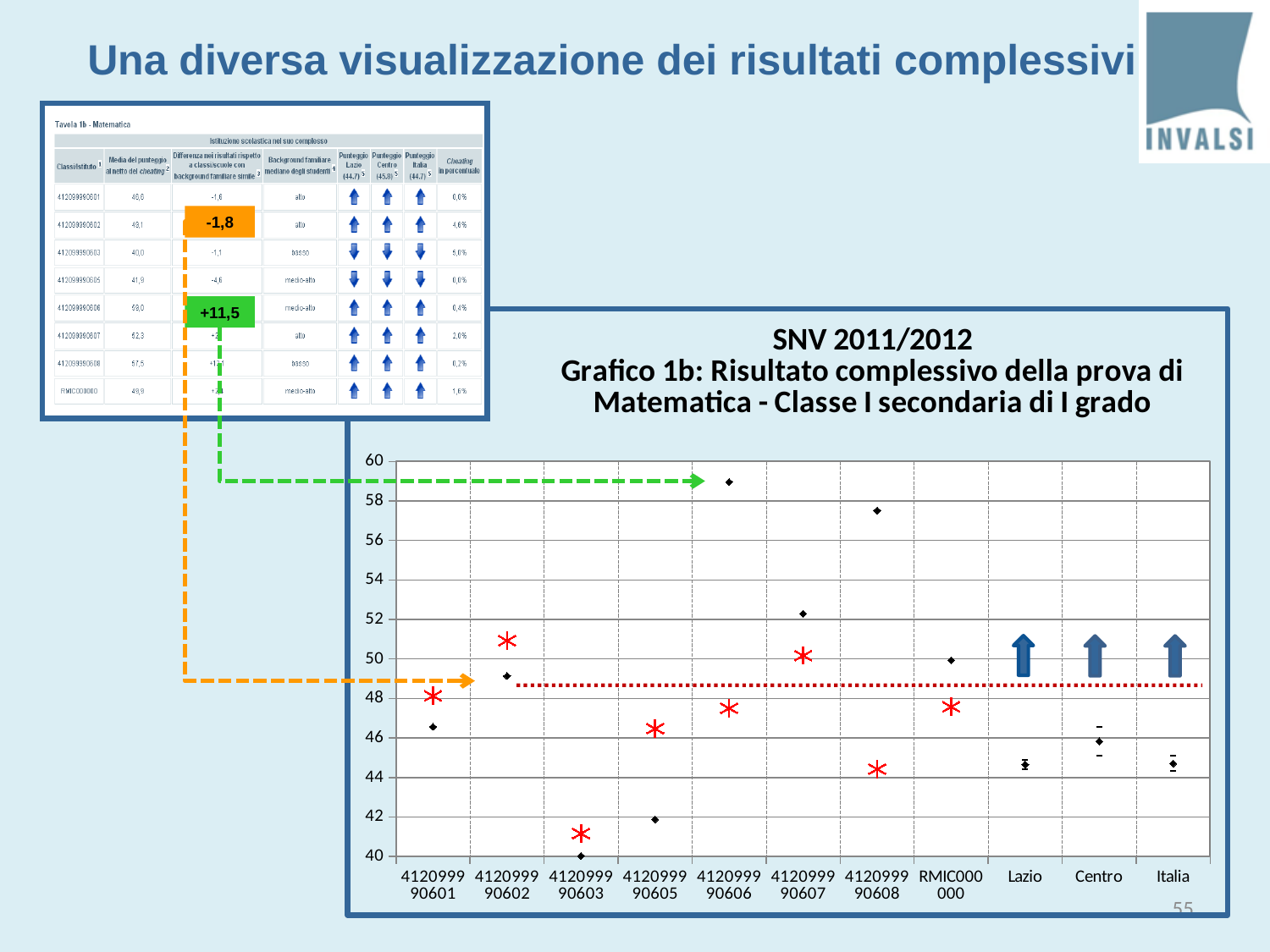
What is the range of the y axis in the chart 'Grafico 1b'? 40 to 60 In the chart 'Grafico 1b', is the value for 412099990605 greater or less than 44? less What kind of chart is 'Grafico 1b: Risultato complessivo della prova di Matematica'? scatter (dot) chart In the chart 'Grafico 1b', which has the larger value: 412099990608 or 412099990607? 412099990608 How many categories are shown on the x axis of the chart 'Grafico 1b'? 11 In the chart 'Grafico 1b', is the value for 412099990606 greater or less than 58? greater In the chart 'Grafico 1b', is the value for 412099990608 greater or less than 56? greater In the chart 'Grafico 1b', which has the larger value: 412099990601 or 412099990602? 412099990602 Which category has the lowest plotted value in the chart 'Grafico 1b: Risultato complessivo della prova di Matematica'? 412099990603 Which category has the highest plotted value in the chart 'Grafico 1b: Risultato complessivo della prova di Matematica'? 412099990606